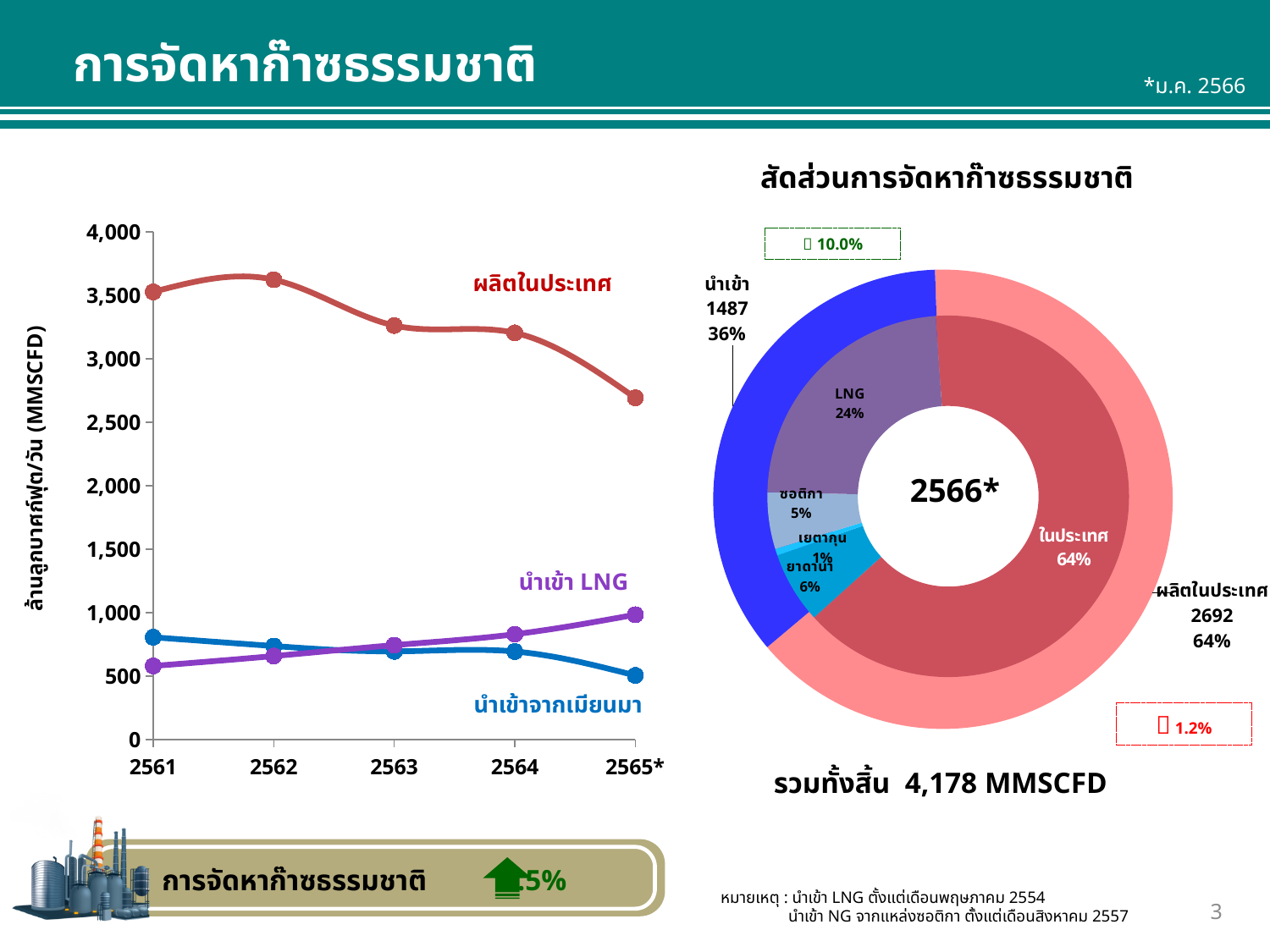
In the line chart on the left, is the value for ผลิตในประเทศ in 2565* greater or less than 3,000? less In the line chart on the left, how many series are plotted? 3 In the line chart on the left, in 2561 which is larger: นำเข้าจากเมียนมา or นำเข้า LNG? นำเข้าจากเมียนมา In the line chart on the left, is the value for นำเข้าจากเมียนมา in 2565* greater or less than 1,000? less In the chart titled สัดส่วนการจัดหาก๊าซธรรมชาติ, what share does นำเข้า have? 36% In the line chart on the left, does the ผลิตในประเทศ series rise or fall from 2561 to 2565*? fall In the line chart on the left, which series has the highest value in 2565*? ผลิตในประเทศ In the chart titled สัดส่วนการจัดหาก๊าซธรรมชาติ, what is the value for ผลิตในประเทศ? 2692 In the chart titled สัดส่วนการจัดหาก๊าซธรรมชาติ, what is the difference between ผลิตในประเทศ (2692) and นำเข้า (1487)? 1205 In the line chart on the left, how many years are shown on the x axis? 5 In the line chart on the left, does the นำเข้า LNG series rise or fall from 2561 to 2565*? rise What kind of chart is the chart on the left of the slide? line chart